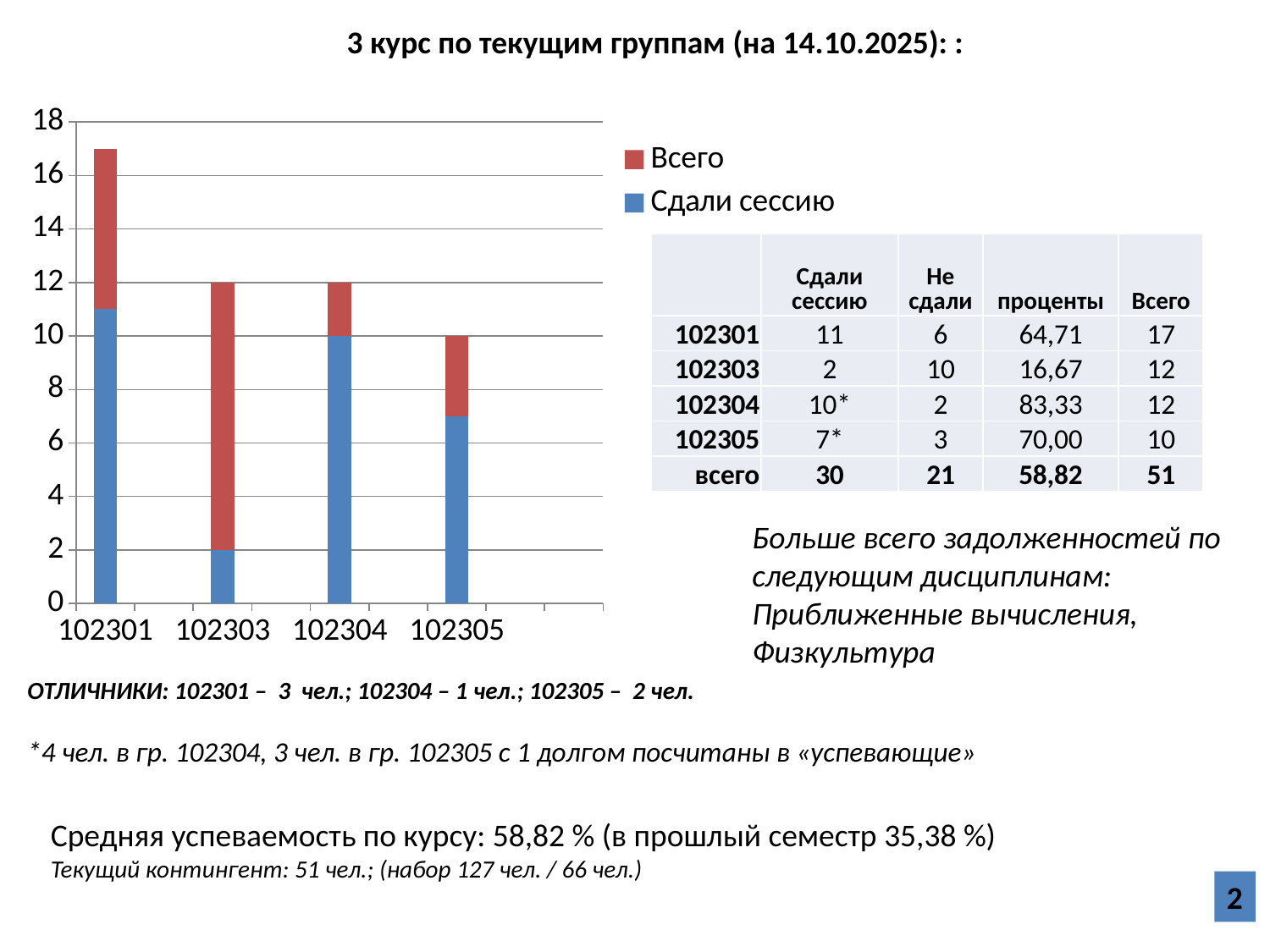
Which group has the larger Сдали сессию value, 102304 or 102305? 102304 How many groups are shown on the x axis of the chart? 4 What is the difference between the total (Всего) values of groups 102301 and 102303? 5 What is the value of Сдали сессию for group 102304? 10 What are the two series named in the chart legend? Всего and Сдали сессию What kind of chart is shown on the slide? bar chart What is the value of Сдали сессию for group 102303? 2 Is the Сдали сессию value for group 102301 greater or less than 10? greater What is the total (Всего) value for group 102301? 17 How many series does the chart legend list? 2 Which group has the highest total (Всего) bar? 102301 Which group has the lowest Сдали сессию value? 102303